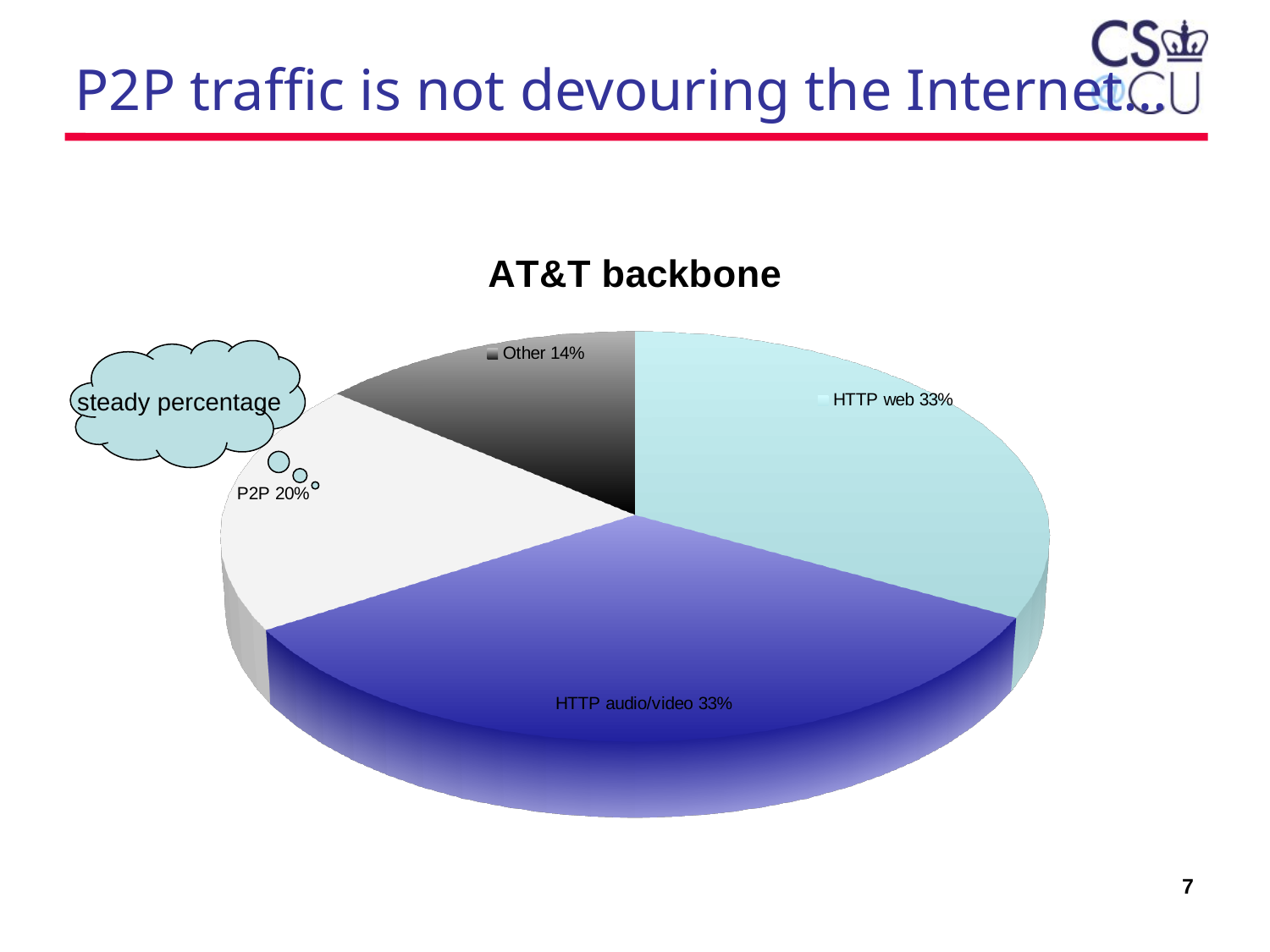
What type of chart is shown on the slide? pie chart What share of the pie does HTTP web account for? 33% What is the title of the pie chart? AT&T backbone What share of the pie does Other account for? 14% Which category has the smallest slice of the pie? Other How many slices does the pie chart have? 4 What is the difference in percentage points between HTTP web and P2P? 13 Which is larger, the P2P slice or the Other slice? P2P What text is written in the cloud callout next to the P2P slice? steady percentage What is the difference in percentage points between P2P and Other? 6 What share of the pie does P2P account for? 20%